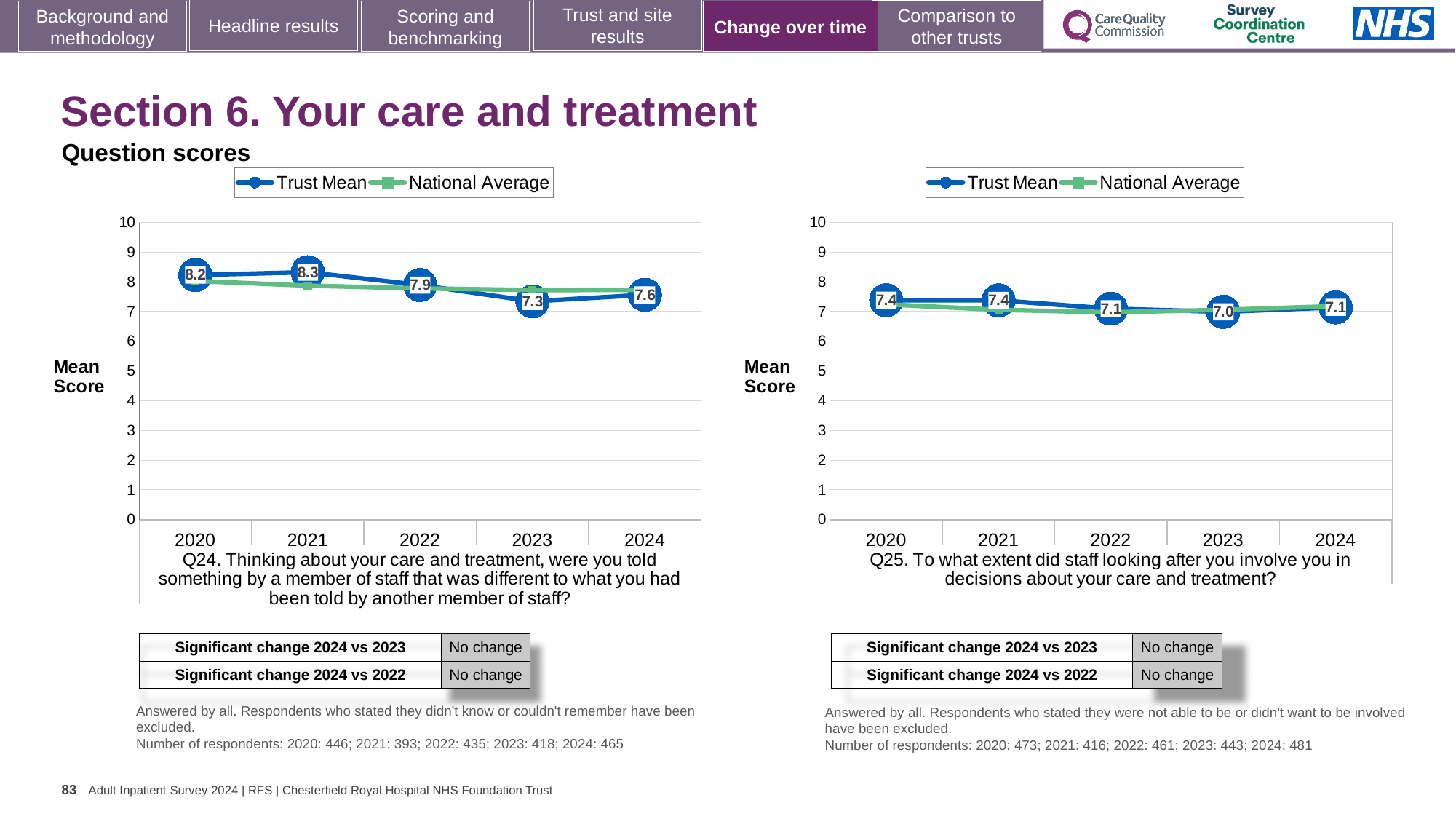
On the Q25 chart (right), is the Trust Mean score for 2020 larger or smaller than the score for 2022? larger On the Q24 chart (left), which year has the lowest Trust Mean score? 2023 On the Q24 chart (left), what is the difference between the Trust Mean scores for 2021 and 2024? 0.7 On the Q25 chart (right), what is the Trust Mean score for 2023? 7.0 On the Q24 chart (left), is the Trust Mean score for 2020 greater or less than 8? greater On the Q24 chart (left), what is the Trust Mean score for 2021? 8.3 On the Q25 chart (right), which year has the lowest Trust Mean score? 2023 What kind of chart is used for Q24 (left)? Line chart How many years are plotted on the x axis of the Q25 chart (right)? 5 On the Q24 chart (left), what is the Trust Mean score for 2023? 7.3 How many series does the legend of the Q24 chart (left) list? 2 On the Q25 chart (right), what is the Trust Mean score for 2024? 7.1